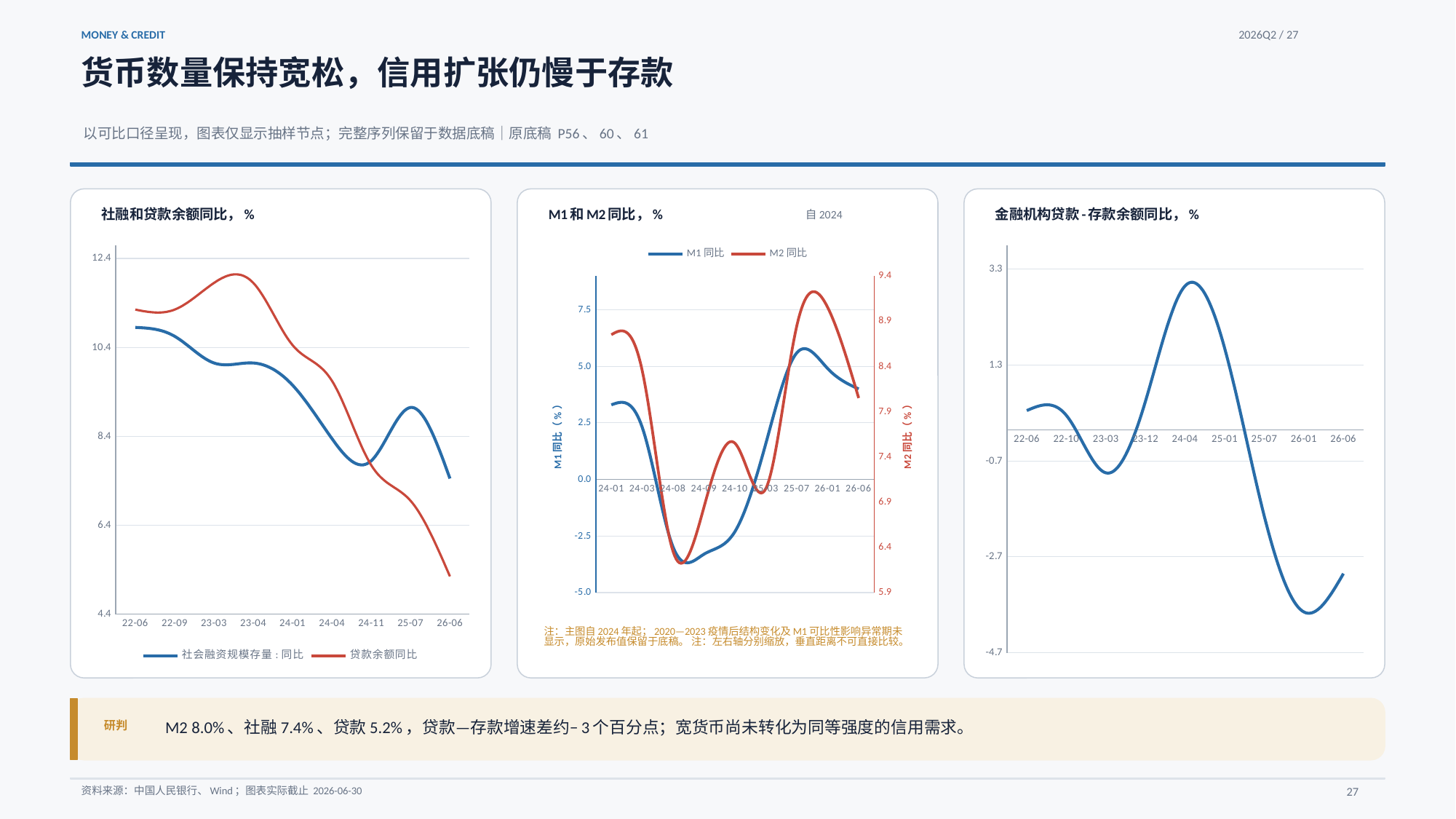
In the chart titled 社融和贷款余额同比，%, is the value of 贷款余额同比 at 26-06 greater or less than 6.4? less What kind of chart is the chart titled 社融和贷款余额同比，%? line chart In the chart titled 社融和贷款余额同比，%, is the value of 社会融资规模存量：同比 at 22-06 greater or less than 10.4? greater In the chart titled 社融和贷款余额同比，%, which series has the higher value at 26-06, 社会融资规模存量：同比 or 贷款余额同比? 社会融资规模存量：同比 In the chart titled 金融机构贷款 - 存款余额同比，%, how many dates are labelled on the x axis? 9 In the chart titled 社融和贷款余额同比，%, how many series does the legend list? 2 In the chart titled 金融机构贷款 - 存款余额同比，%, do the values rise or fall between 24-04 and 26-01? fall In the chart titled 金融机构贷款 - 存款余额同比，%, is the value at 24-04 greater or less than 1.3? greater In the chart titled M1 和 M2 同比，%, how many series does the legend list? 2 In the chart titled M1 和 M2 同比，%, what is the label of the right-hand y axis? M2 同比（%） In the chart titled 社融和贷款余额同比，%, how many dates are labelled on the x axis? 9